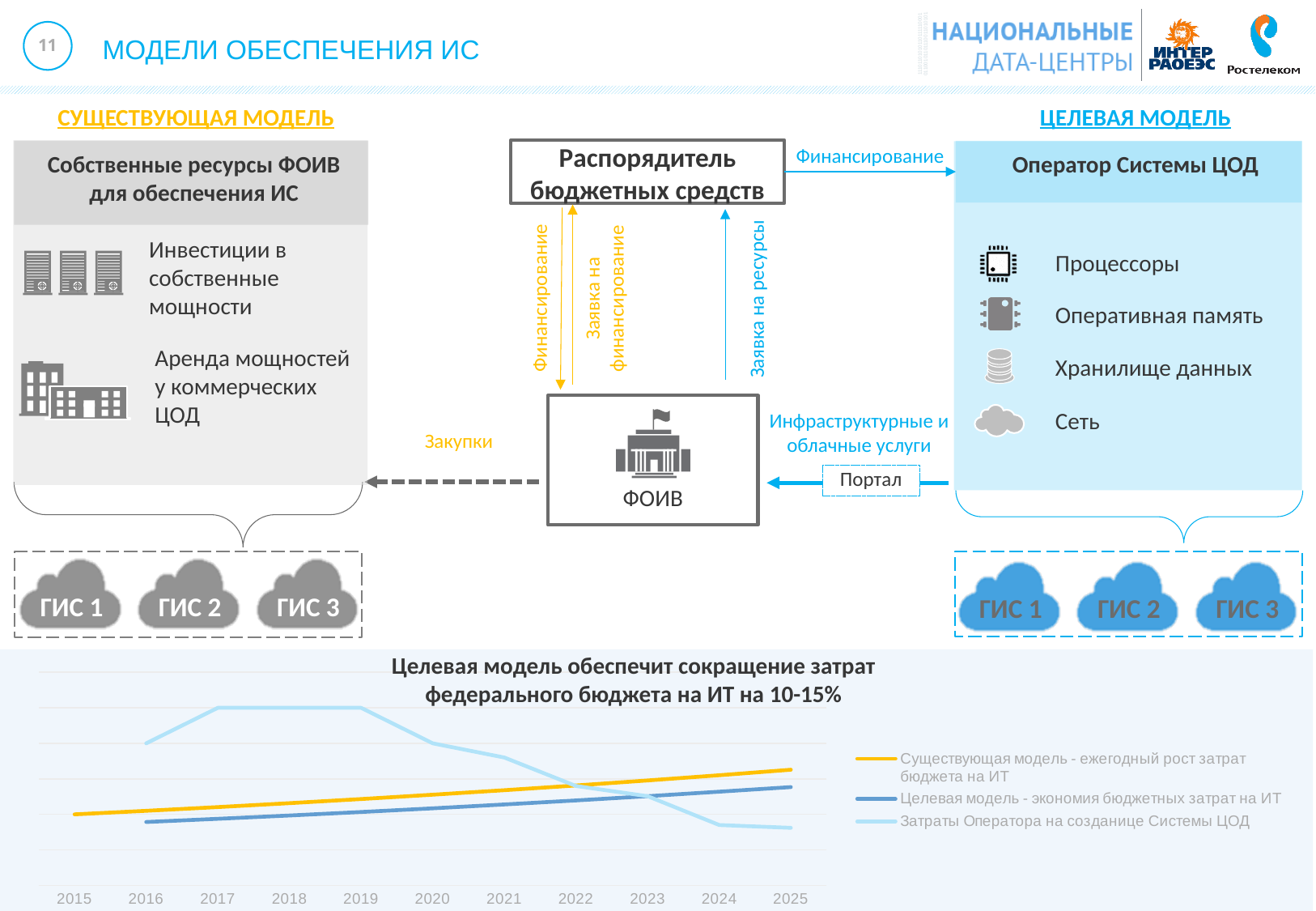
In the bottom chart, which series is higher in 2016: 'Затраты Оператора на созданице Системы ЦОД' or 'Существующая модель - ежегодный рост затрат бюджета на ИТ'? Затраты Оператора на созданице Системы ЦОД How many years are labelled on the x axis of the bottom chart? 11 In the bottom chart, which series is higher in 2025: 'Существующая модель - ежегодный рост затрат бюджета на ИТ' or 'Целевая модель - экономия бюджетных затрат на ИТ'? Существующая модель - ежегодный рост затрат бюджета на ИТ What kind of chart is shown at the bottom of the slide? line chart What is the title of the bottom chart? Целевая модель обеспечит сокращение затрат федерального бюджета на ИТ на 10-15% In the bottom chart, which series has the highest value in 2017? Затраты Оператора на созданице Системы ЦОД What is the first year shown on the x axis of the bottom chart? 2015 In the bottom chart, does the series 'Затраты Оператора на созданице Системы ЦОД' rise or fall from 2019 to 2025? falls In the bottom chart, does the series 'Целевая модель - экономия бюджетных затрат на ИТ' rise or fall from 2016 to 2025? rises How many series does the legend of the bottom chart list? 3 What is the last year shown on the x axis of the bottom chart? 2025 In the bottom chart, does the series 'Существующая модель - ежегодный рост затрат бюджета на ИТ' rise or fall from 2015 to 2025? rises